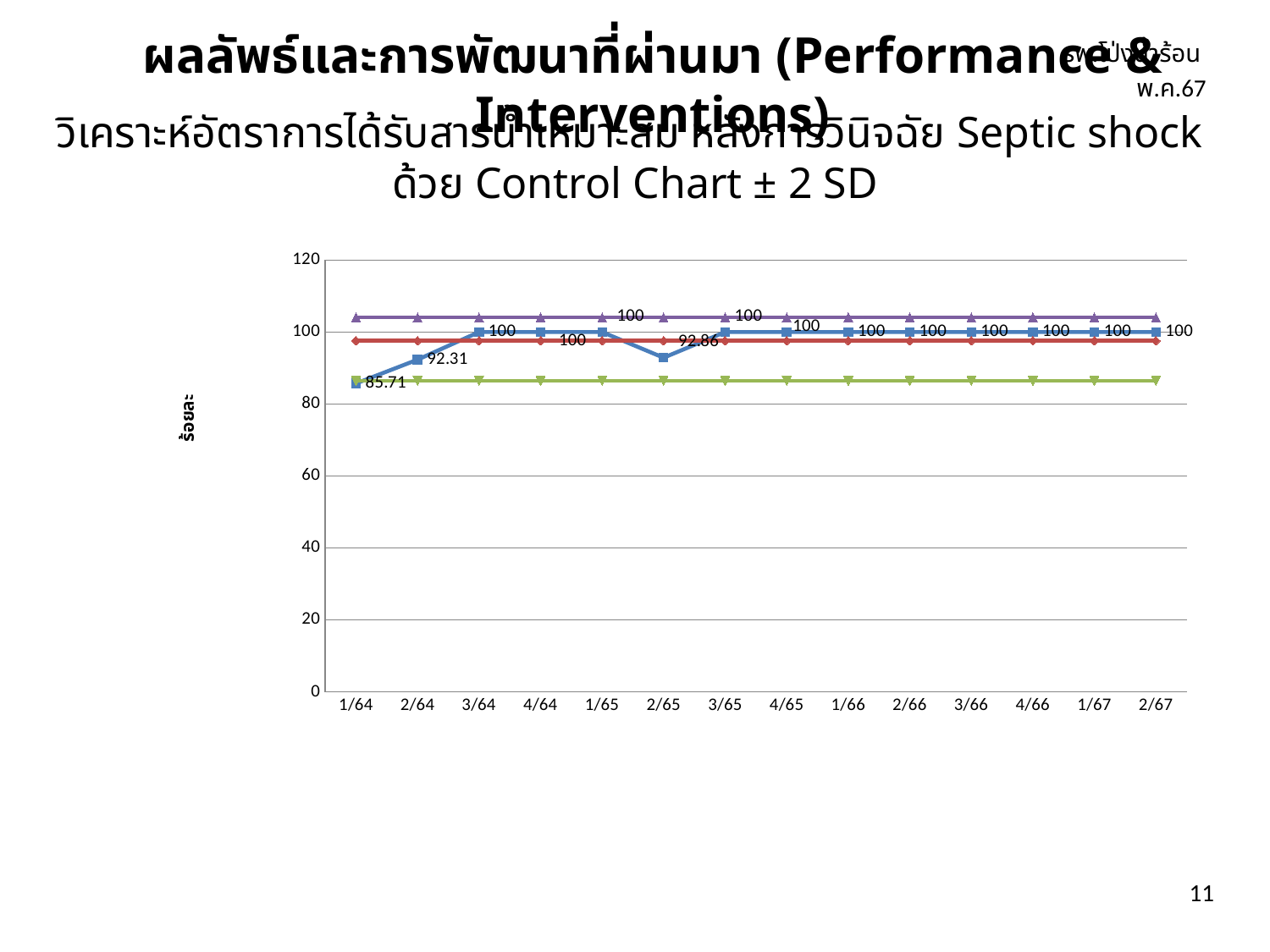
What is the difference between the labelled values for 2/64 and 1/64? 6.6 What is the labelled value for 2/64 on the chart? 92.31 What is the difference between the labelled values for 1/65 and 2/65? 7.14 How many time periods are shown on the x axis of the chart? 14 Do the labelled values rise or fall from 1/64 to 3/64? rise What is the labelled value for 1/64 on the chart? 85.71 Which period has the lowest labelled value on the chart? 1/64 Which has the larger labelled value, 2/64 or 2/65? 2/65 What kind of chart is shown on the slide? line chart What is the labelled value for 2/65 on the chart? 92.86 What is the label on the y axis of the chart? ร้อยละ What is the labelled value for 3/64 on the chart? 100